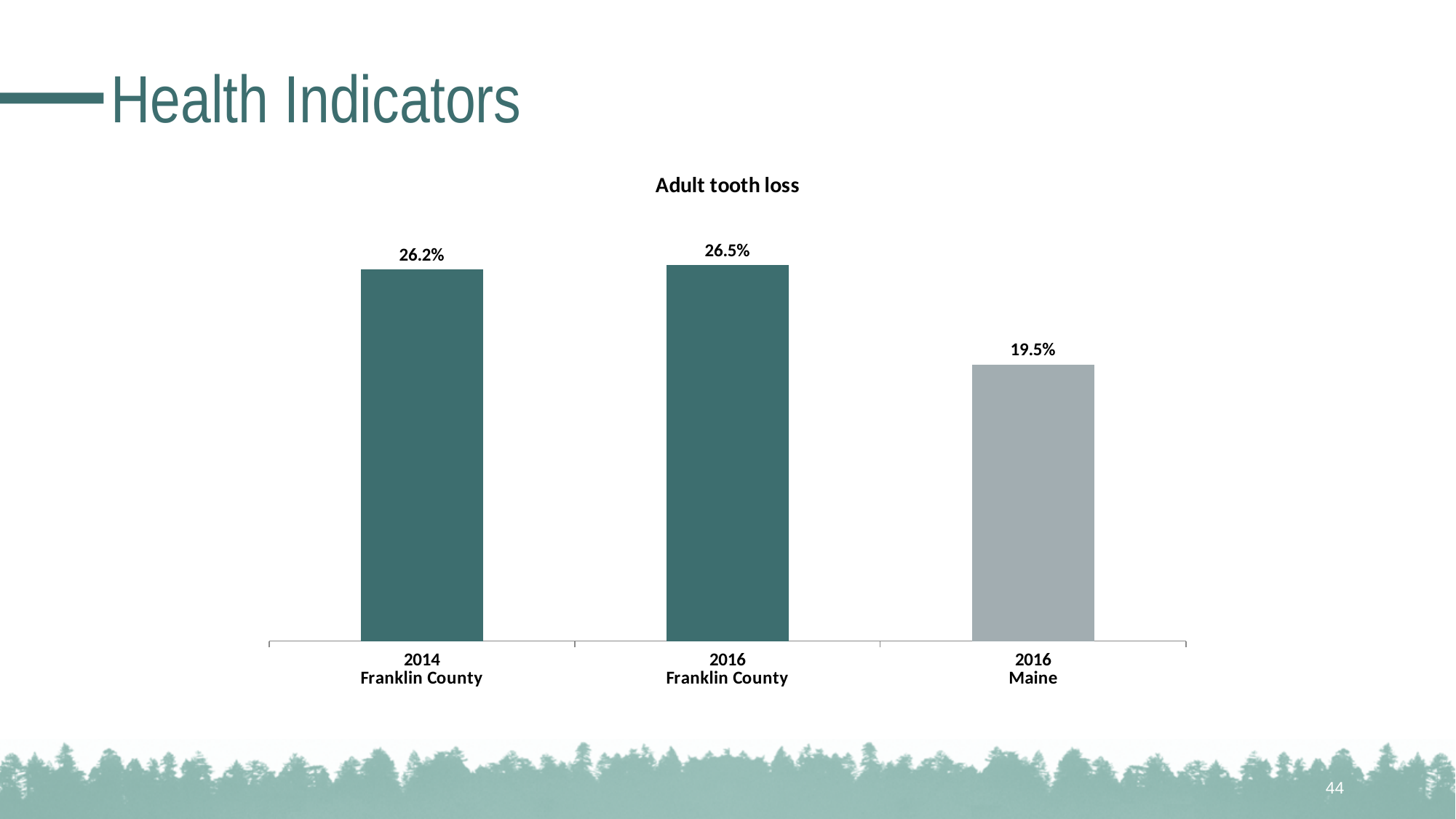
What is the title of the chart? Adult tooth loss What is the adult tooth loss value for Maine in 2016? 19.5% What is the adult tooth loss value for Franklin County in 2014? 26.2% What is the adult tooth loss value for Franklin County in 2016? 26.5% How many bars are shown in the chart? 3 What is the difference between the 2016 Franklin County value and the 2016 Maine value? 7.0% Which is larger, the 2014 Franklin County value or the 2016 Maine value? 2014 Franklin County What is the difference between the 2016 and 2014 Franklin County values? 0.3% Which bar is shown in a different (grey) colour from the others? 2016 Maine What kind of chart is shown on the slide? Bar chart Which category has the lowest adult tooth loss value? 2016 Maine